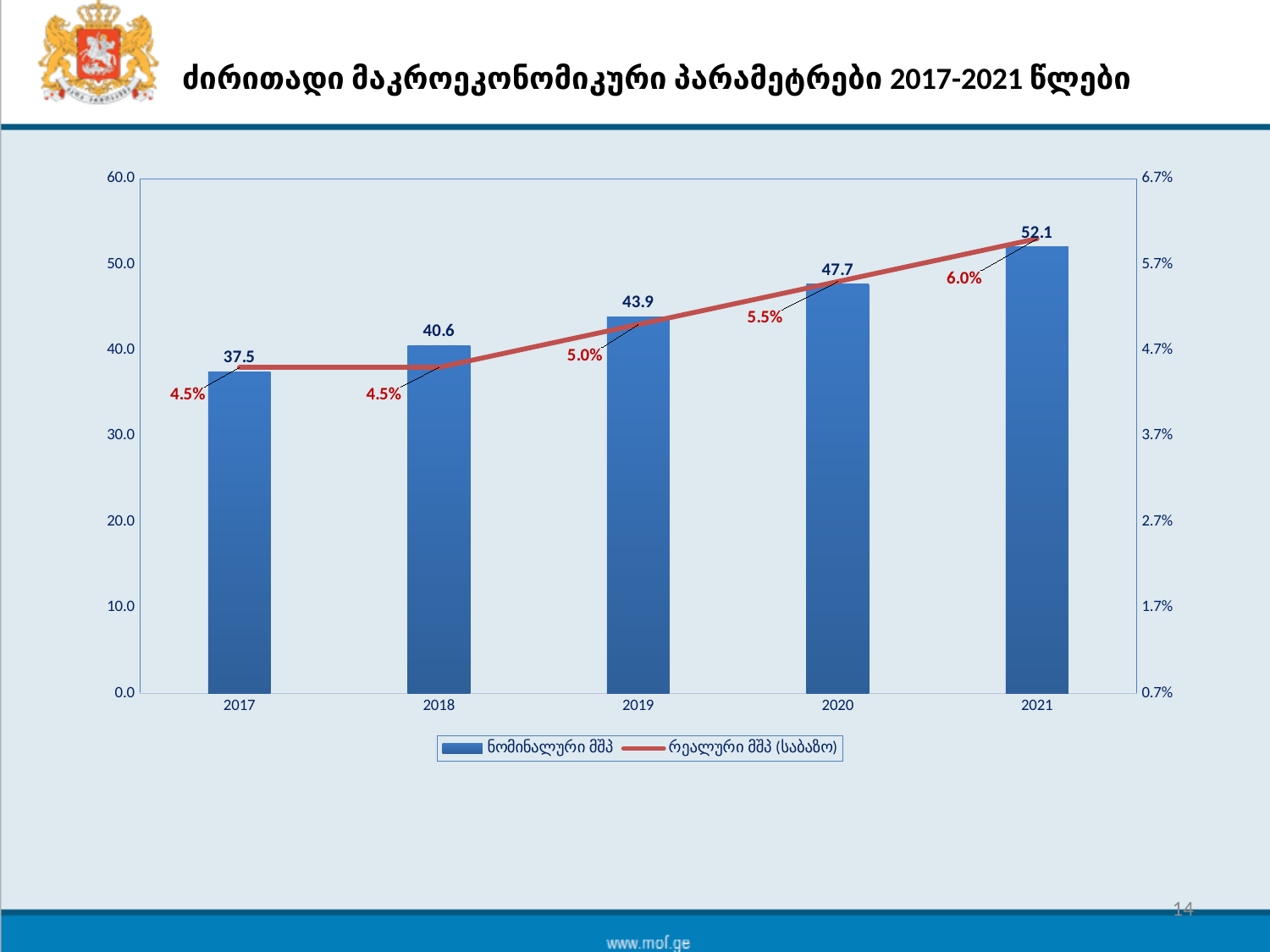
How many years are shown on the x axis? 5 What is the value of the bar for 2021? 52.1 What is the difference between the bar values for 2021 and 2017? 14.6 Which year has the lowest bar value? 2017 What value does the red line (რეალური მშპ (საბაზო)) show for 2021? 6.0% What is the value of the bar for 2017? 37.5 What is the difference between the bar values for 2020 and 2019? 3.8 Which year has the highest bar value? 2021 Which is larger, the bar value for 2018 or for 2019? 2019 Do the bar values rise or fall from 2017 to 2021? rise What value does the red line (რეალური მშპ (საბაზო)) show for 2019? 5.0% How many series does the legend list? 2